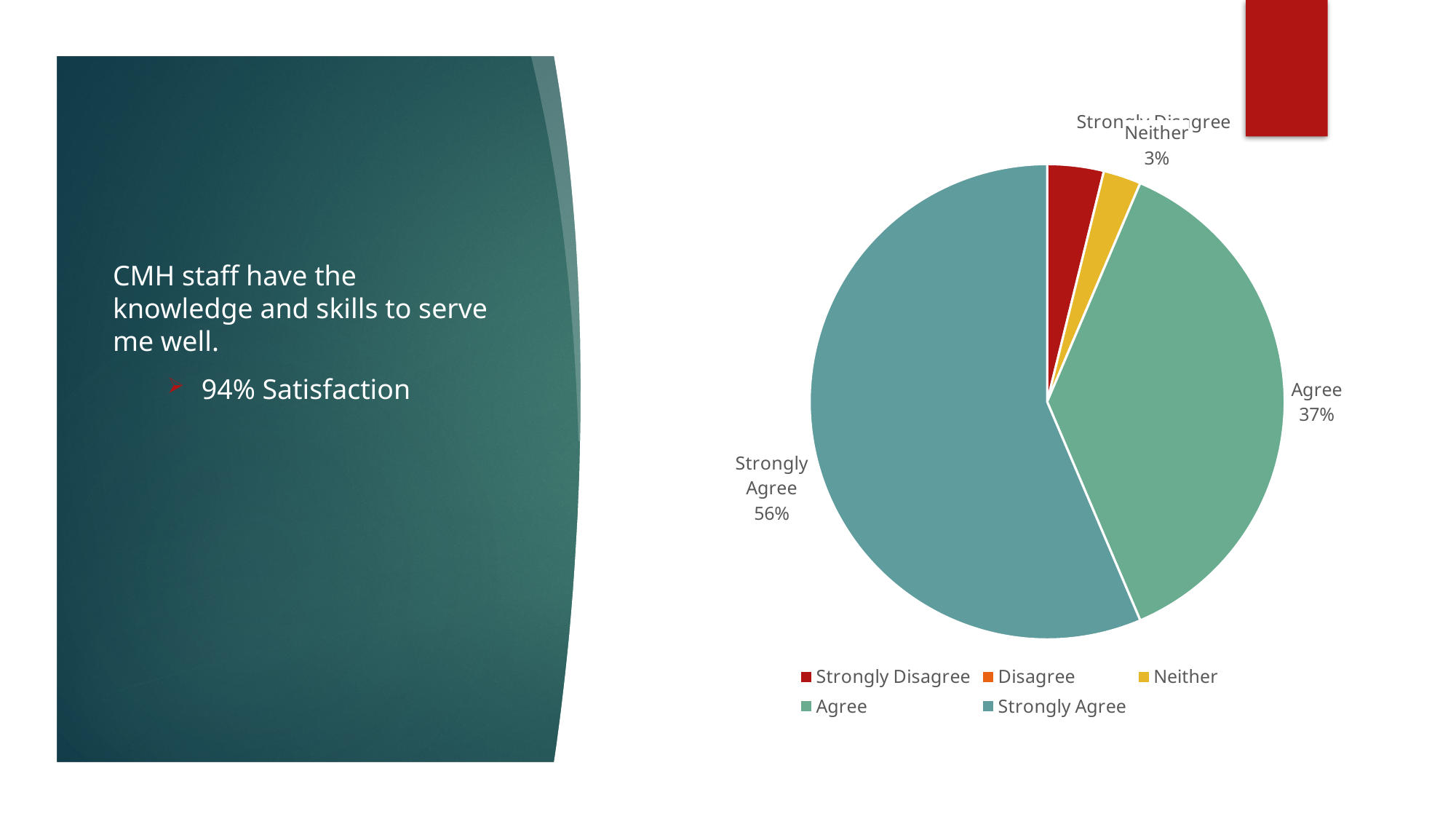
Which slice is larger, Agree or Strongly Agree? Strongly Agree What is the difference in percentage points between the Strongly Agree and Agree slices? 19 What share of the pie does the Agree slice represent? 37% How many categories does the chart's legend list? 5 Which category has the largest slice of the pie chart? Strongly Agree Which slice is larger, Neither or Agree? Agree What colour represents Neither in the legend? yellow What colour represents Strongly Disagree in the legend? red What percentage of the pie chart is labelled Strongly Agree? 56% What percentage of the pie chart is labelled Agree? 37% What percentage of the pie chart is labelled Neither? 3% What kind of chart is shown on the slide? pie chart